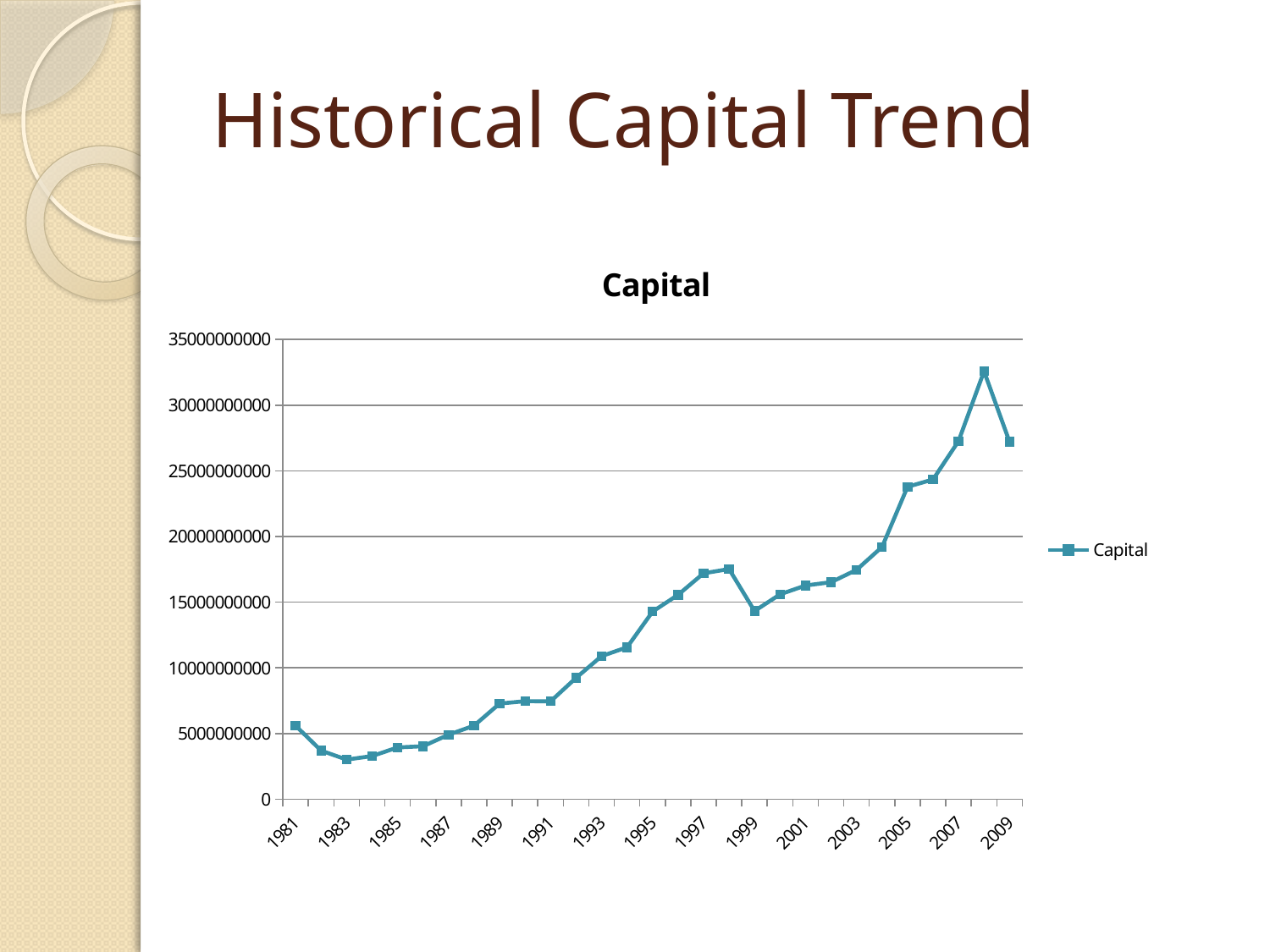
Is the Capital value for 1983 greater or less than 5000000000? less Overall, do the Capital values rise or fall from 1981 to 2009? rise What is the title of the chart? Capital What kind of chart is shown on the slide? line chart How many years are plotted on the x axis? 29 Is the Capital value for 1999 greater or less than 15000000000? less How many series does the legend list? 1 In which year is the Capital value highest? 2008 What is the name of the series shown in the legend? Capital Is the Capital value for 2008 greater or less than 30000000000? greater In which year is the Capital value lowest? 1983 Which year has the larger Capital value, 2008 or 2009? 2008